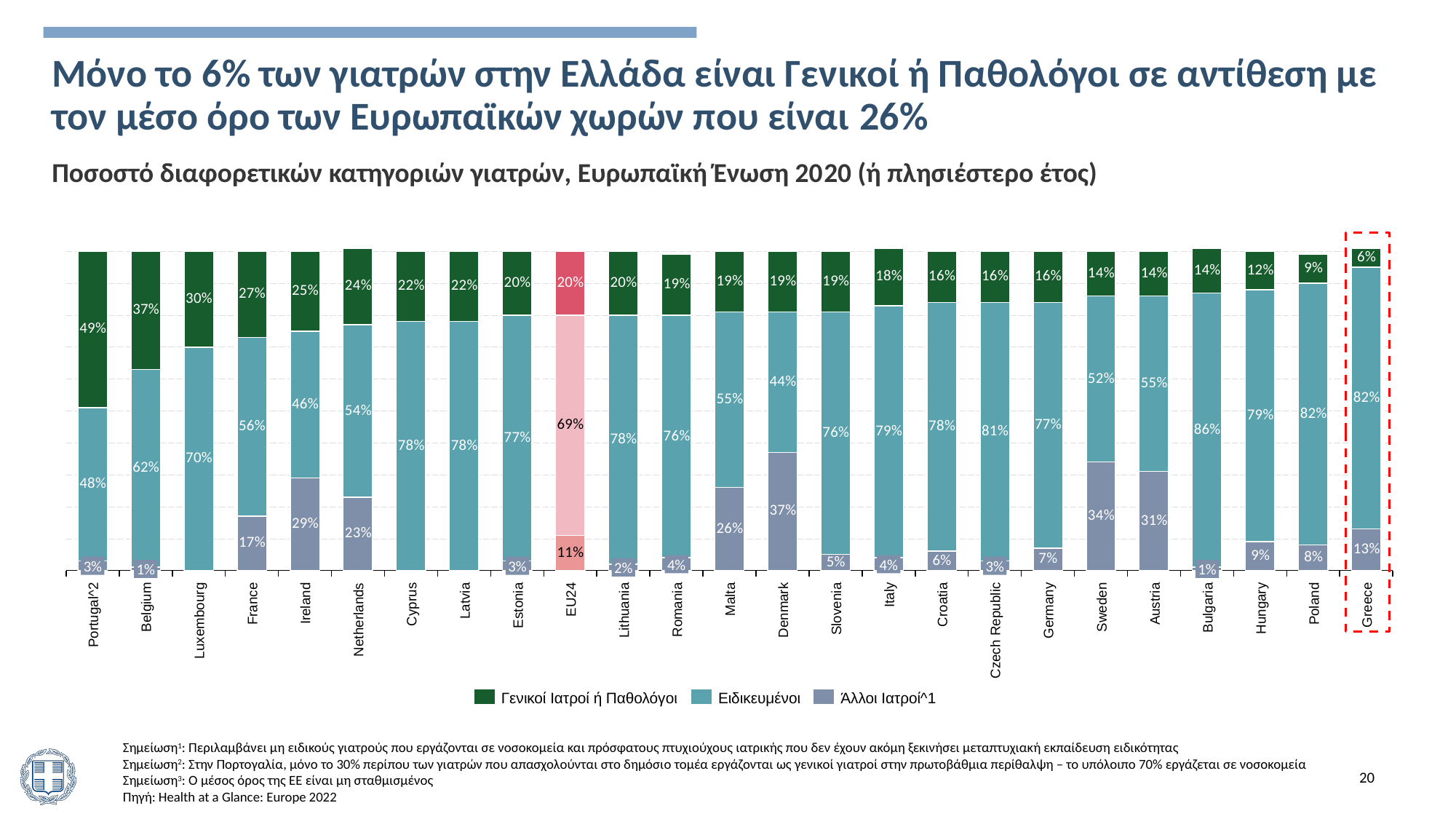
How many series does the legend list? 3 Which country has the lowest share of Γενικοί Ιατροί ή Παθολόγοι? Greece What is the Άλλοι Ιατροί^1 share for Denmark? 37% How many countries/regions are shown on the x axis? 25 What type of chart is shown on the slide? Stacked bar chart Which country has the highest share of Γενικοί Ιατροί ή Παθολόγοι? Portugal^2 What percentage of doctors in Greece are Γενικοί Ιατροί ή Παθολόγοι? 6% Which country has the highest Ειδικευμένοι share? Bulgaria What is the Ειδικευμένοι share for EU24? 69% Which country's bar is outlined with a red dashed box? Greece What is the difference in percentage points between the Γενικοί Ιατροί ή Παθολόγοι share of EU24 and that of Greece? 14 percentage points Which has a larger Άλλοι Ιατροί^1 share, Sweden or Austria? Sweden